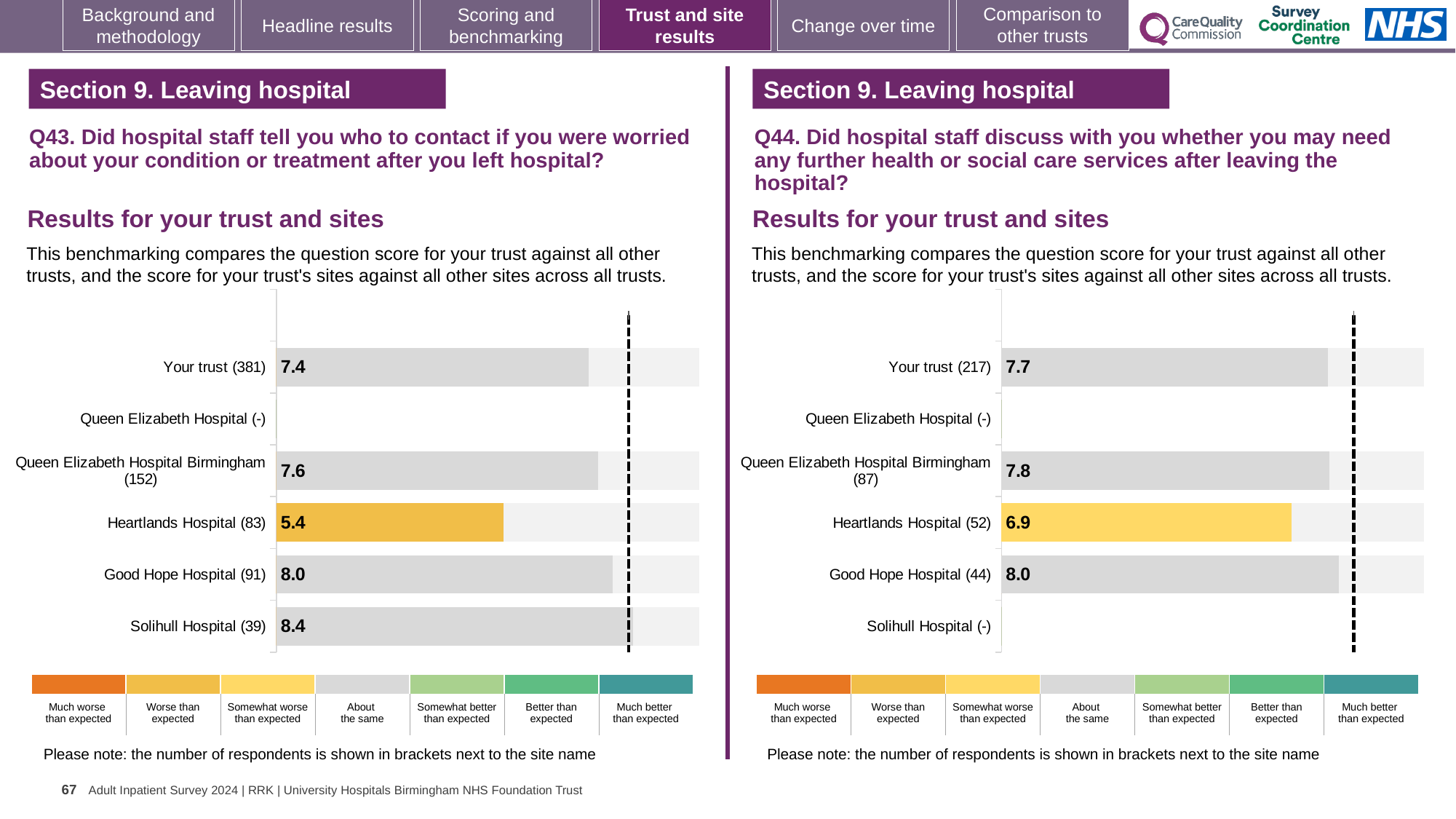
In the Q43 chart on the left, what is the difference between the scores for Solihull Hospital (39) and Heartlands Hospital (83)? 3.0 In the Q44 chart on the right, what is the score for Good Hope Hospital (44)? 8.0 In the Q43 chart on the left, which site has the highest score? Solihull Hospital (39) In the Q44 chart on the right, what is the score for Your trust (217)? 7.7 In the Q44 chart on the right, which site has the lowest score? Heartlands Hospital (52) In the Q43 chart on the left, which site has the lowest score? Heartlands Hospital (83) In the Q43 chart on the left, how many categories are listed on the vertical axis? 6 In the Q43 chart on the left, which has the higher score: Good Hope Hospital (91) or Queen Elizabeth Hospital Birmingham (152)? Good Hope Hospital (91) What kind of chart is the Q44 chart on the right? Bar chart In the Q43 chart on the left, what is the score for Your trust (381)? 7.4 In the Q43 chart on the left, what is the score for Heartlands Hospital (83)? 5.4 In the Q44 chart on the right, what is the difference between the scores for Good Hope Hospital (44) and Heartlands Hospital (52)? 1.1